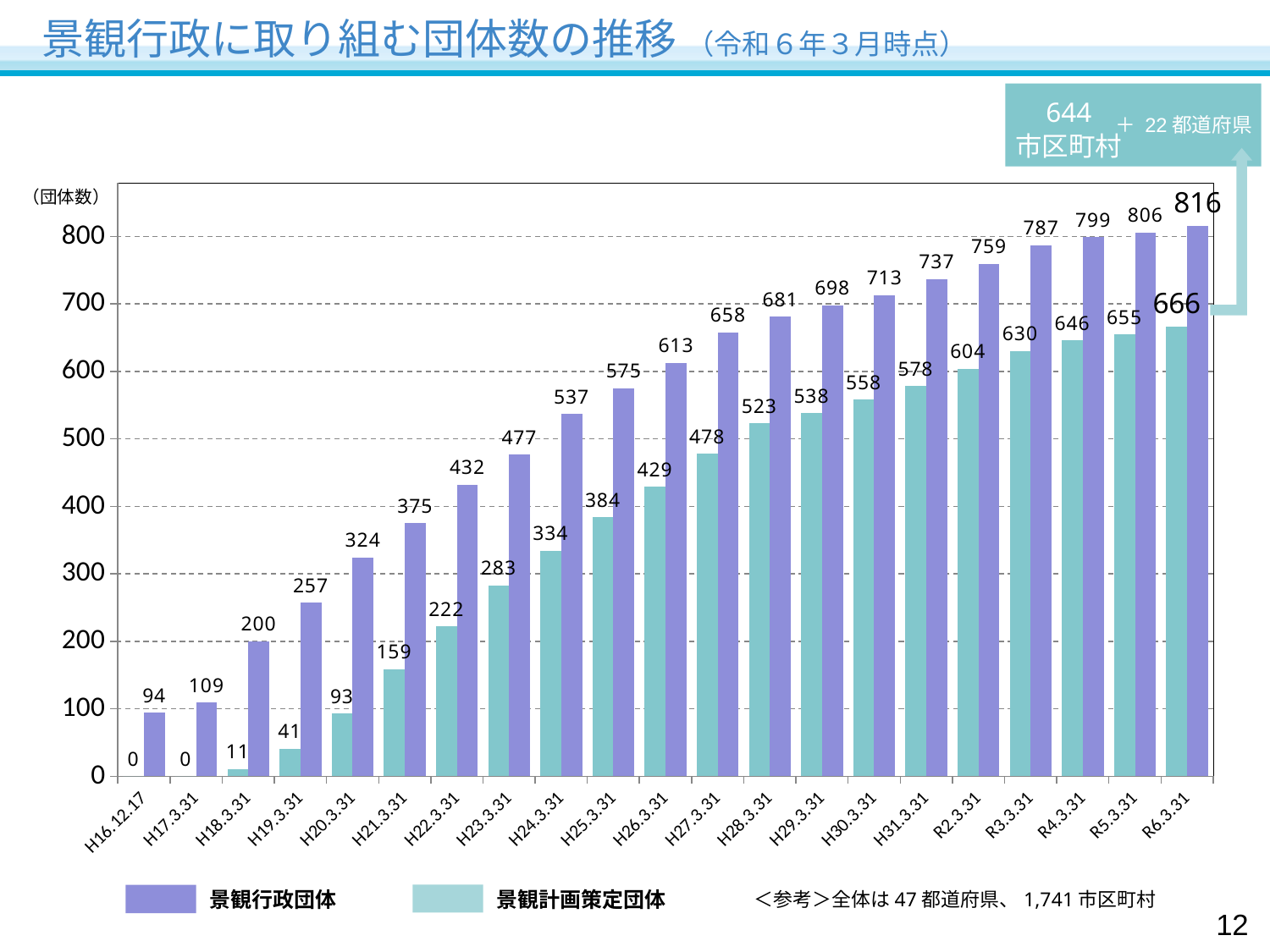
How many categories are shown on the x axis? 21 Which category has the highest value for 景観計画策定団体? R6.3.31 What is the difference between the 景観行政団体 values at H25.3.31 and H24.3.31? 38 Which is larger: 景観計画策定団体 at H28.3.31 or 景観行政団体 at H23.3.31? 景観計画策定団体 at H28.3.31 What is the difference between 景観行政団体 and 景観計画策定団体 at R6.3.31? 150 Do the values for 景観行政団体 rise or fall along the x axis? Rise What is the value of 景観計画策定団体 at H24.3.31? 334 What kind of chart is shown on the slide? Bar chart What is the value of 景観行政団体 at R6.3.31? 816 How many series does the legend list? 2 What is the value of 景観行政団体 at H20.3.31? 324 Which category has the lowest value for 景観行政団体? H16.12.17